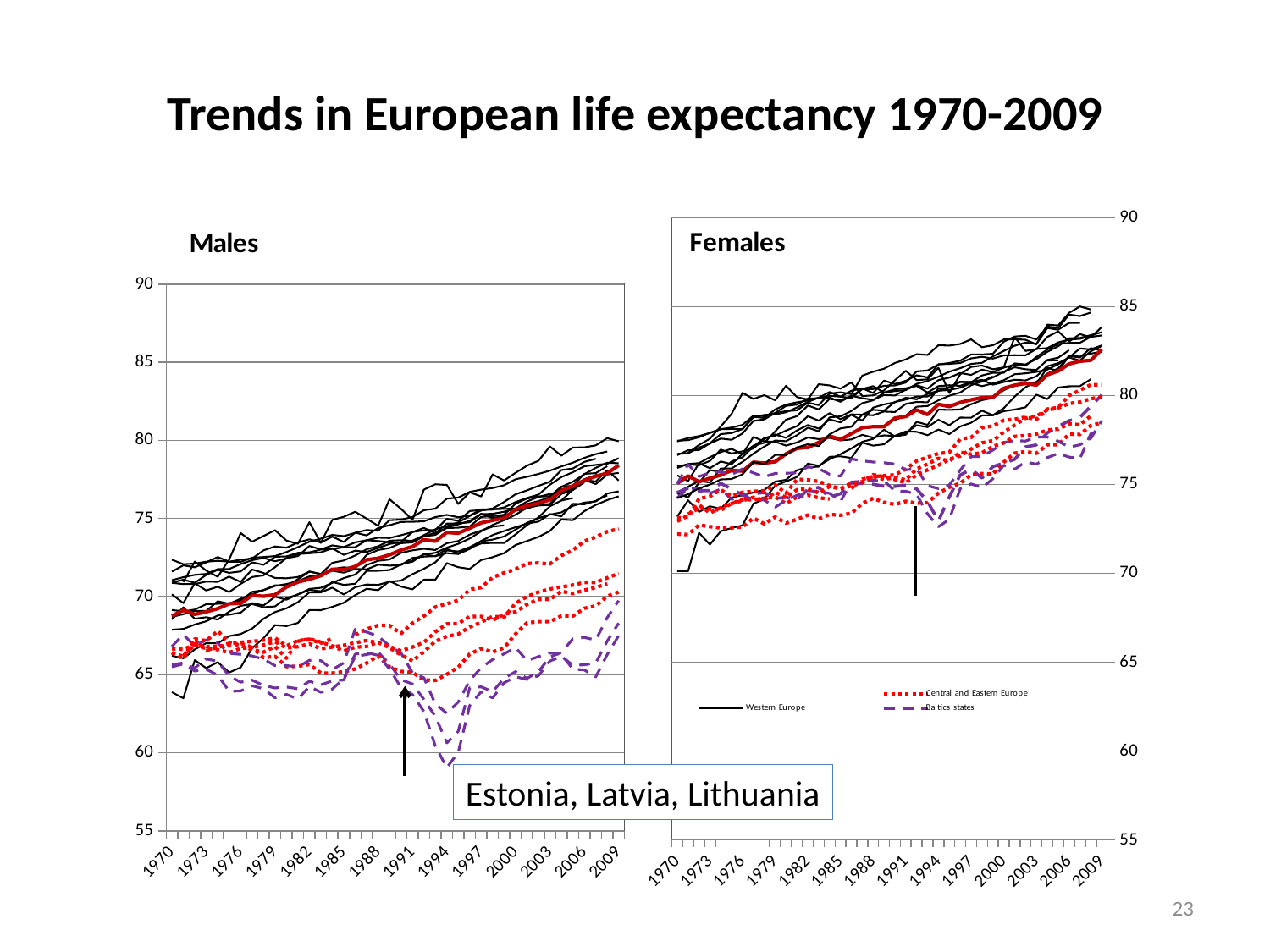
Which three groups are named in the legend? Western Europe, Central and Eastern Europe, Baltics states In the Males chart, which group has higher values in 2009, Western Europe or Baltics states? Western Europe What is the title of the slide's chart? Trends in European life expectancy 1970-2009 In the Females chart, do the Central and Eastern Europe lines generally rise or fall over the period? Rise In the Females chart, which group has lower values in 2009, Western Europe or Central and Eastern Europe? Central and Eastern Europe In the Females chart, are the Western Europe values in 2009 greater or less than 80? greater In the Males chart, do the Western Europe lines rise or fall from 1970 to 2009? Rise In the Males chart, are the Western Europe values in 1970 greater or less than 75? less How many series does the legend list? 3 What kind of chart is used on this slide for the Males and Females panels? Line chart In the Females chart, are the Baltics states values in 1970 greater or less than 80? less